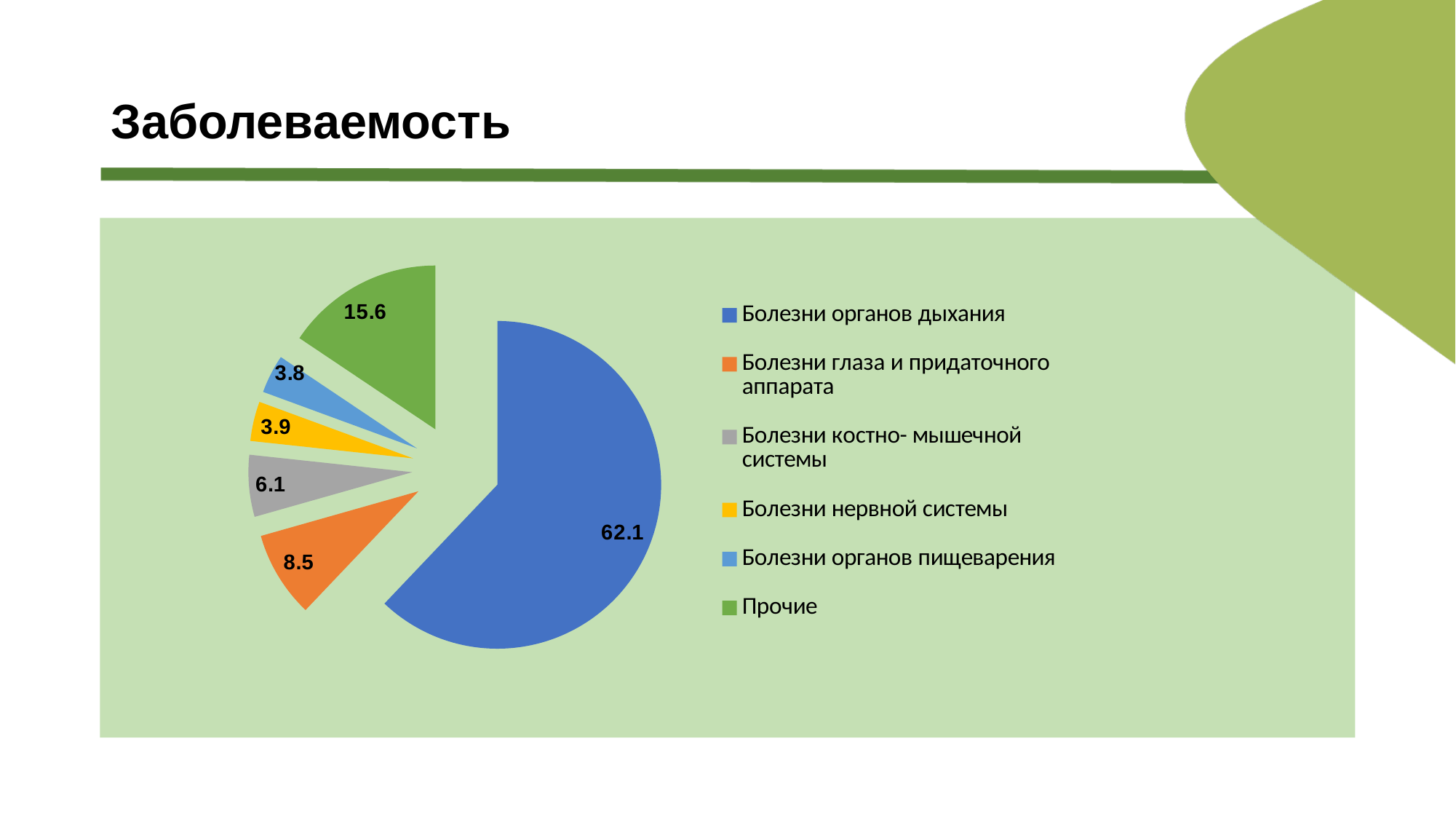
What is the value for Болезни нервной системы? 3.9 Which category has the largest slice of the pie? Болезни органов дыхания What is the difference between the values for Болезни органов дыхания and Прочие? 46.5 What colour is the slice for Прочие? Green What is the value for Болезни глаза и придаточного аппарата? 8.5 What is the value for Болезни костно- мышечной системы? 6.1 What is the value for Болезни органов дыхания? 62.1 How many categories does the pie chart have? 6 Which category has the smallest slice of the pie? Болезни органов пищеварения What type of chart is shown on the slide? Pie chart What is the value for Прочие? 15.6 Which is larger, the value for Болезни глаза и придаточного аппарата or the value for Болезни костно- мышечной системы? Болезни глаза и придаточного аппарата